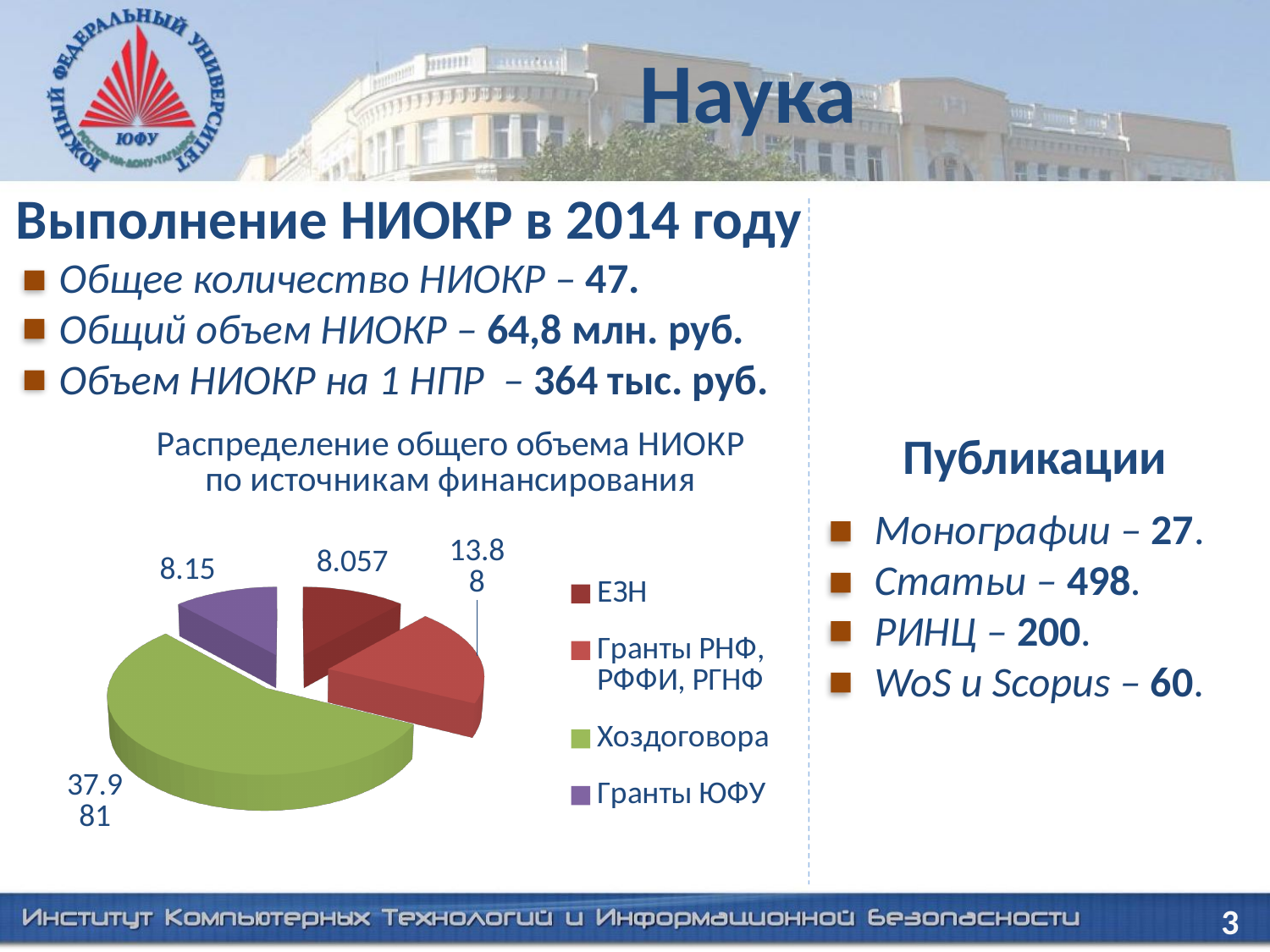
Which is larger in the pie chart: Гранты РНФ, РФФИ, РГНФ or Гранты ЮФУ? Гранты РНФ, РФФИ, РГНФ How many slices does the pie chart have? 4 What is the value shown for Гранты РНФ, РФФИ, РГНФ in the pie chart? 13.88 Which funding source has the smallest value in the pie chart? ЕЗН What is the value shown for ЕЗН in the pie chart? 8.057 How many entries does the legend of the pie chart list? 4 What is the difference between the values for Хоздоговора and Гранты РНФ, РФФИ, РГНФ in the pie chart? 24.101 What is the value shown for Гранты ЮФУ in the pie chart? 8.15 What is the value shown for Хоздоговора in the pie chart? 37.981 What is the title of the pie chart? Распределение общего объема НИОКР по источникам финансирования What kind of chart is shown on the slide? Pie chart Which funding source has the largest slice in the pie chart? Хоздоговора